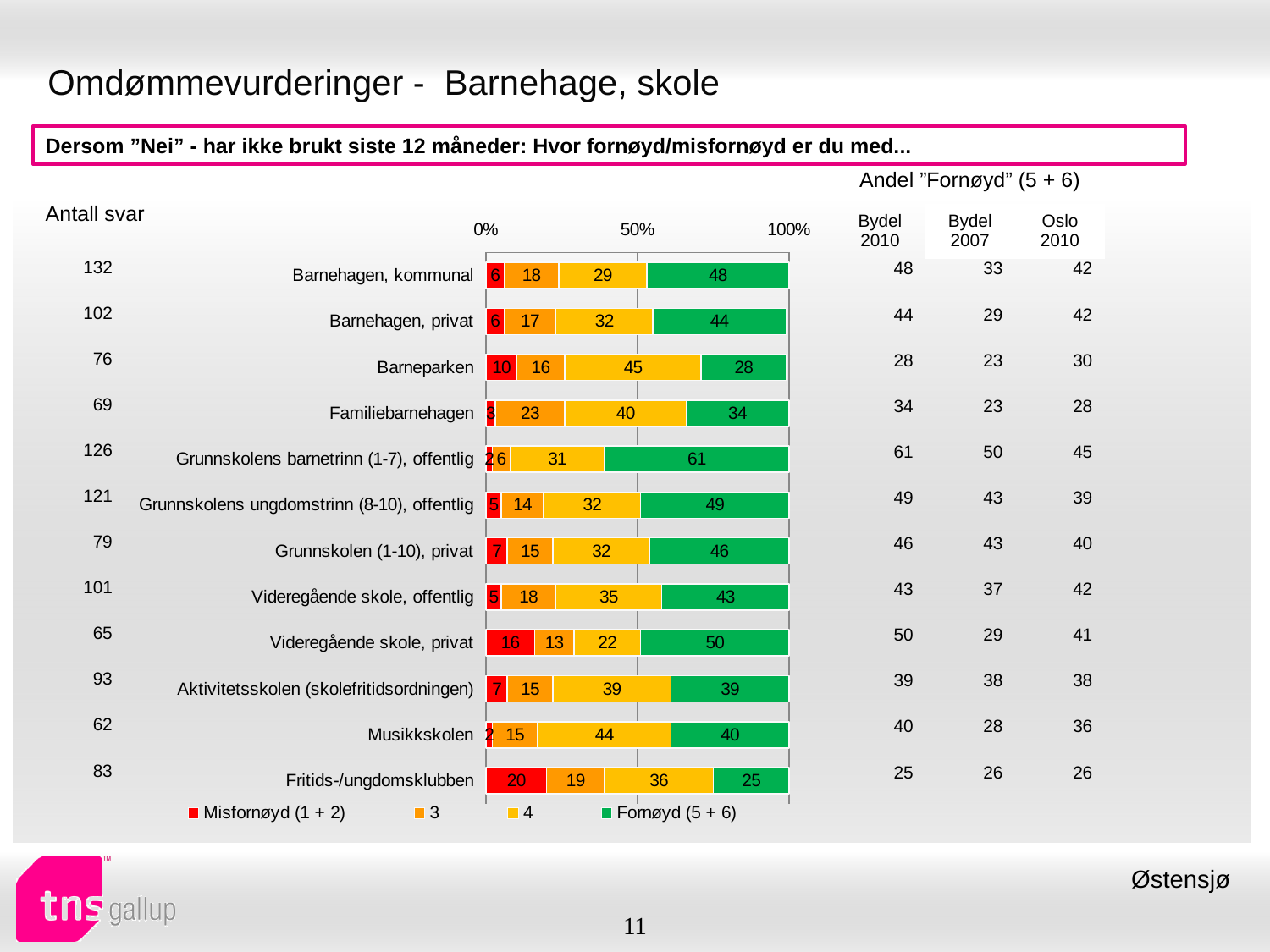
What is the value of the '4' segment for Barneparken? 45 Which has a larger Fornøyd (5 + 6) value: Videregående skole, privat or Videregående skole, offentlig? Videregående skole, privat What is the value of the '3' segment for Familiebarnehagen? 23 What is the total of the stacked bar for Aktivitetsskolen (skolefritidsordningen)? 100 What is the value of the Fornøyd (5 + 6) segment for Barneparken? 28 How many categories are shown in the chart? 12 Which category has the highest Fornøyd (5 + 6) value? Grunnskolens barnetrinn (1-7), offentlig Which category has the highest Misfornøyd (1 + 2) value? Fritids-/ungdomsklubben How many series does the legend list? 4 Which category has the lowest Fornøyd (5 + 6) value? Fritids-/ungdomsklubben What is the difference between the Fornøyd (5 + 6) values for Barnehagen, kommunal and Barnehagen, privat? 4 What kind of chart is shown on the slide? Stacked bar chart